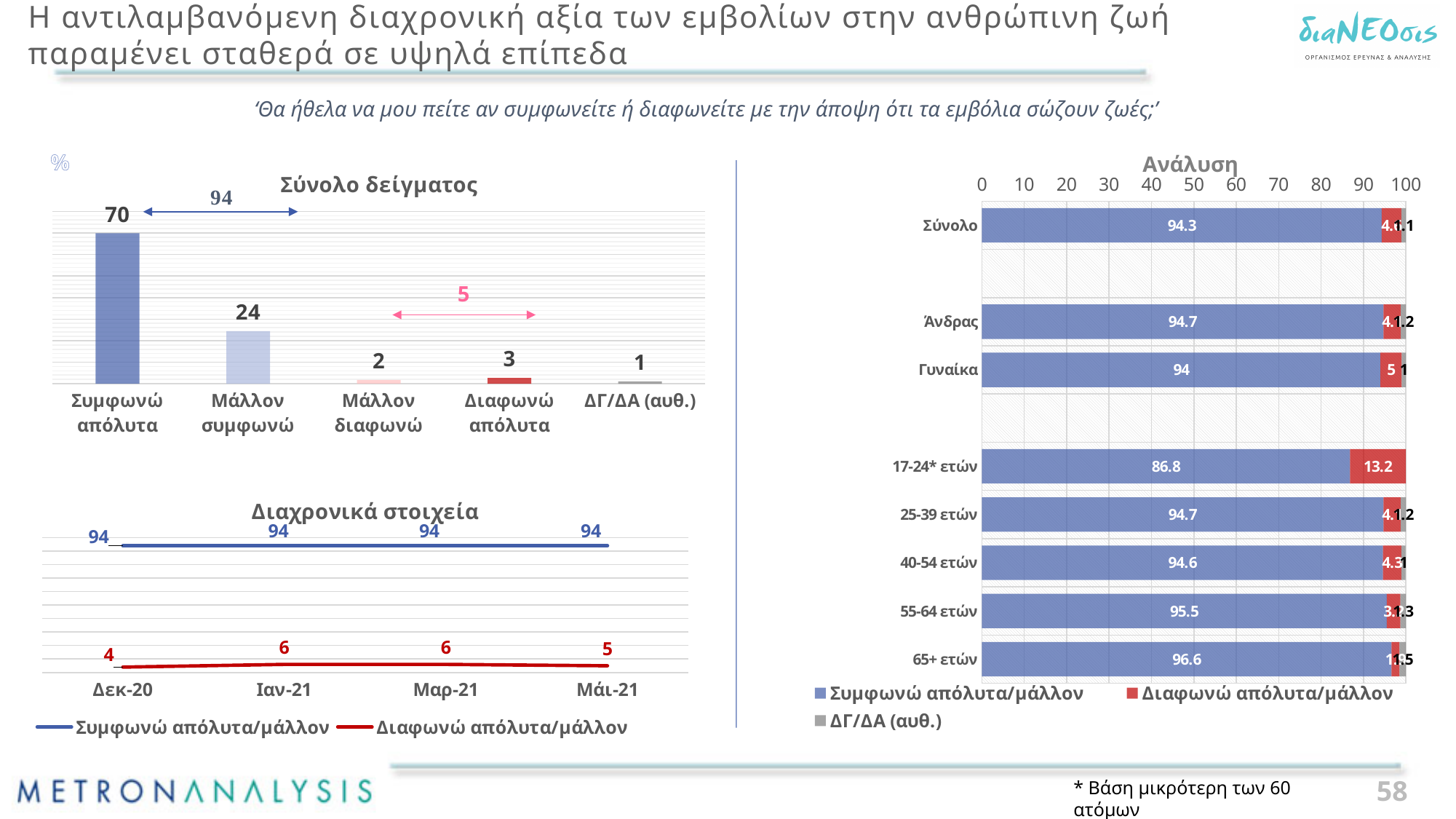
In the 'Σύνολο δείγματος' chart, what is the difference between 'Συμφωνώ απόλυτα' and 'Μάλλον συμφωνώ'? 46 In the 'Διαχρονικά στοιχεία' chart, what kind of chart is used? line chart In the 'Ανάλυση' chart, what is the value of 'Διαφωνώ απόλυτα/μάλλον' for '17-24* ετών'? 13.2 In the 'Διαχρονικά στοιχεία' chart, what is the value of 'Συμφωνώ απόλυτα/μάλλον' at Μάι-21? 94 In the 'Σύνολο δείγματος' chart, which category has the lowest value? ΔΓ/ΔΑ (αυθ.) In the 'Σύνολο δείγματος' chart, what is the value for 'Μάλλον συμφωνώ'? 24 In the 'Σύνολο δείγματος' chart, what is the value for 'Συμφωνώ απόλυτα'? 70 In the 'Διαχρονικά στοιχεία' chart, how many series does the legend list? 2 In the 'Σύνολο δείγματος' chart, how many categories are shown? 5 In the 'Ανάλυση' chart, which group has the highest value for 'Συμφωνώ απόλυτα/μάλλον'? 65+ ετών In the 'Ανάλυση' chart, what is the value of 'Συμφωνώ απόλυτα/μάλλον' for '17-24* ετών'? 86.8 In the 'Διαχρονικά στοιχεία' chart, what is the value of 'Διαφωνώ απόλυτα/μάλλον' at Ιαν-21? 6